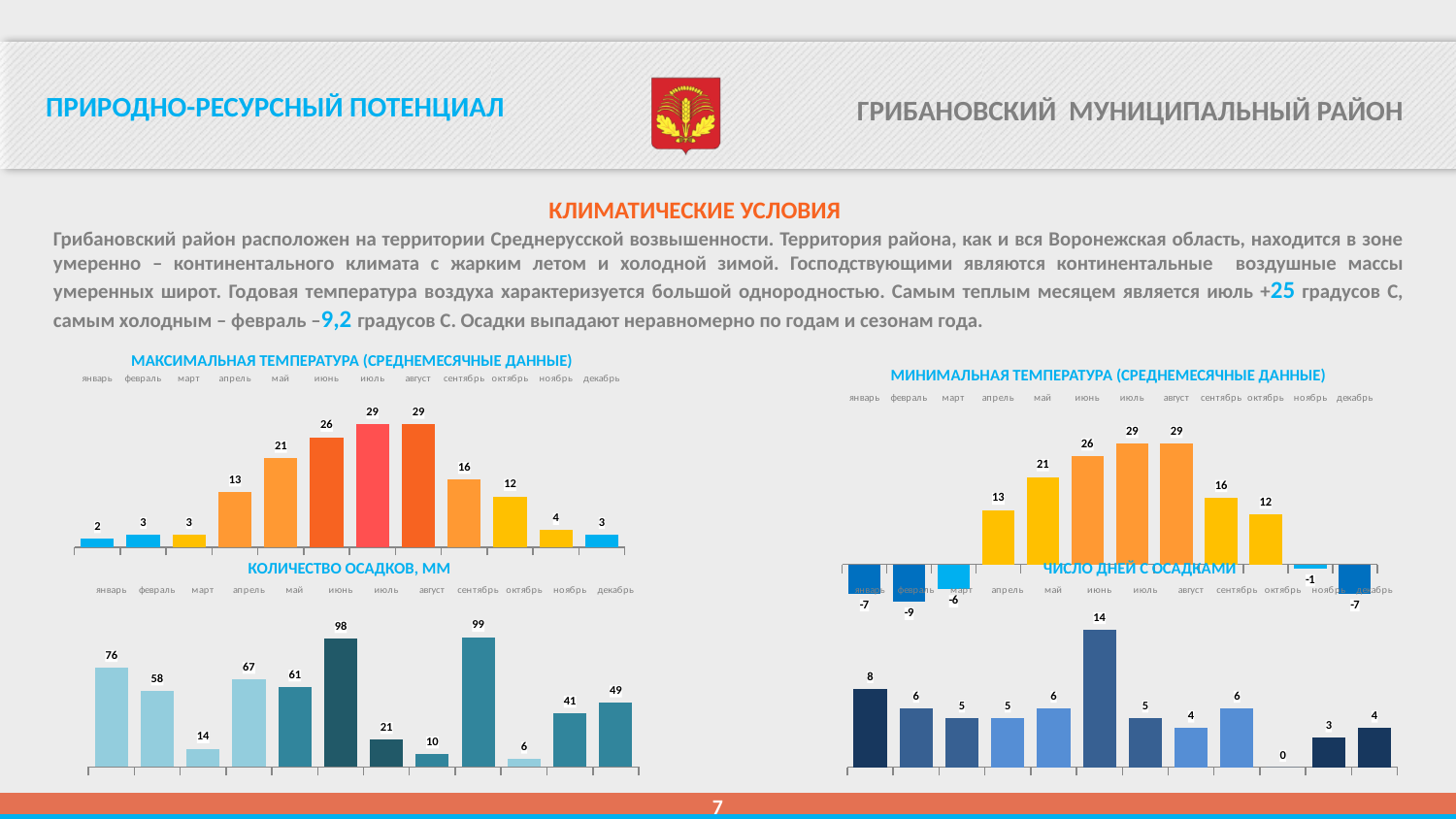
In the chart 'МАКСИМАЛЬНАЯ ТЕМПЕРАТУРА (СРЕДНЕМЕСЯЧНЫЕ ДАННЫЕ)', do the values rise or fall from январь to июль? rise In the chart 'МИНИМАЛЬНАЯ ТЕМПЕРАТУРА (СРЕДНЕМЕСЯЧНЫЕ ДАННЫЕ)', what is the value for февраль? -9 In the chart 'ЧИСЛО ДНЕЙ С ОСАДКАМИ', what is the value for октябрь? 0 In the chart 'КОЛИЧЕСТВО ОСАДКОВ, ММ', what is the value for сентябрь? 99 What kind of chart is 'КОЛИЧЕСТВО ОСАДКОВ, ММ'? bar chart In the chart 'МАКСИМАЛЬНАЯ ТЕМПЕРАТУРА (СРЕДНЕМЕСЯЧНЫЕ ДАННЫЕ)', which is larger, the value for апрель or the value for октябрь? апрель In the chart 'МИНИМАЛЬНАЯ ТЕМПЕРАТУРА (СРЕДНЕМЕСЯЧНЫЕ ДАННЫЕ)', which month has the lowest value? февраль In the chart 'МАКСИМАЛЬНАЯ ТЕМПЕРАТУРА (СРЕДНЕМЕСЯЧНЫЕ ДАННЫЕ)', what is the value for май? 21 In the chart 'ЧИСЛО ДНЕЙ С ОСАДКАМИ', which month has the highest value? июнь In the chart 'КОЛИЧЕСТВО ОСАДКОВ, ММ', which month has the lowest value? октябрь How many months are shown in the chart 'ЧИСЛО ДНЕЙ С ОСАДКАМИ'? 12 In the chart 'КОЛИЧЕСТВО ОСАДКОВ, ММ', what is the difference between the values for январь and февраль? 18